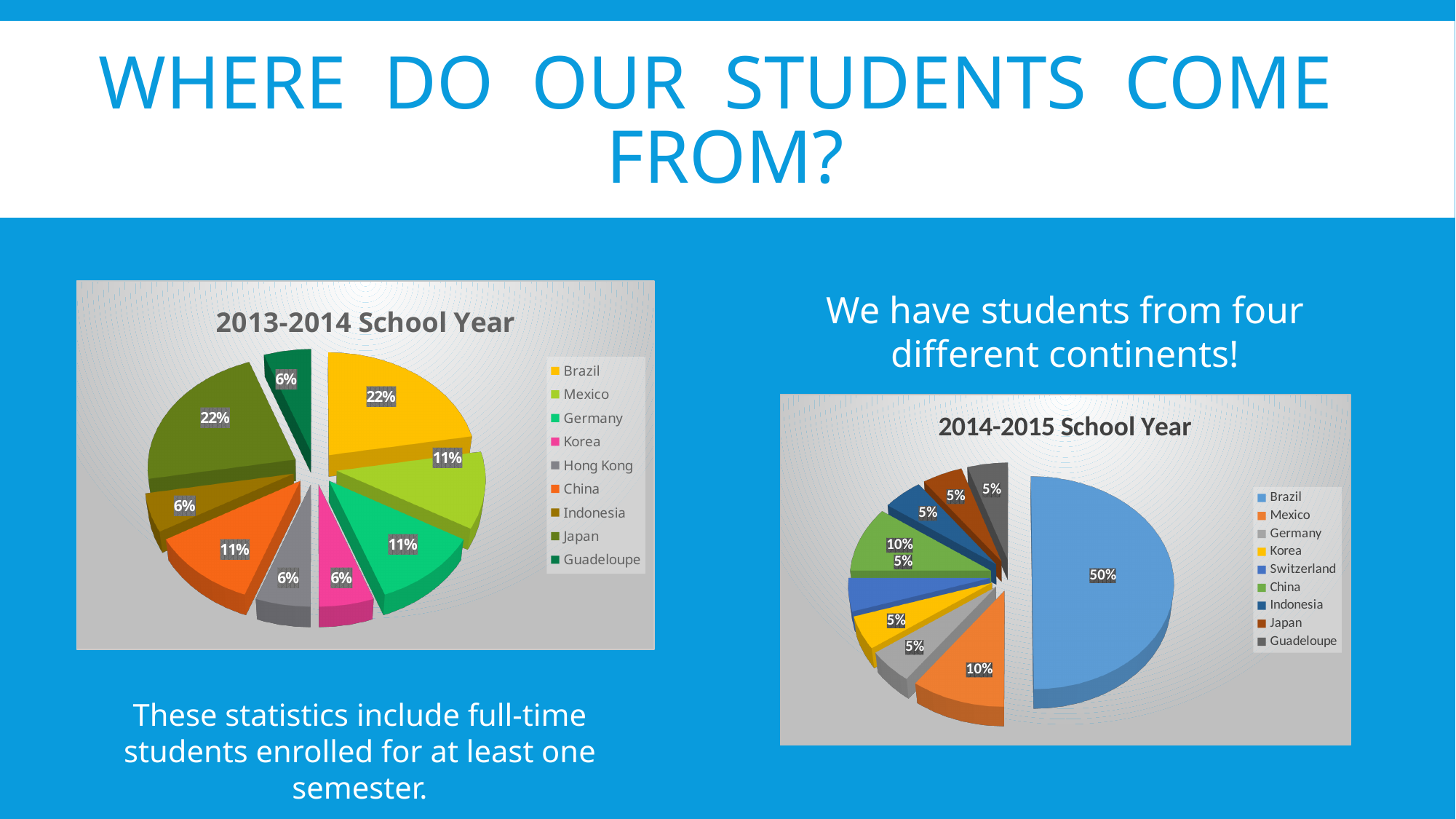
In the 2014-2015 School Year chart, what is the difference between the Brazil share and the China share? 40% In the 2013-2014 School Year chart, what share of students came from Hong Kong? 6% In the 2013-2014 School Year chart, which is larger, the slice for Mexico or the slice for Korea? Mexico What kind of chart is the 2014-2015 School Year chart? Pie chart Which country appears in the legend of the 2014-2015 School Year chart but not in the 2013-2014 School Year chart? Switzerland How many countries are listed in the legend of the 2013-2014 School Year chart? 9 What is the title of the chart on the left side of the slide? 2013-2014 School Year In the 2014-2015 School Year chart, what share of students came from Mexico? 10% In the 2014-2015 School Year chart, which country has the largest slice? Brazil In the 2013-2014 School Year chart, what share of students came from China? 11% In the 2013-2014 School Year chart, what share of students came from Brazil? 22% In the 2014-2015 School Year chart, what share of students came from Brazil? 50%